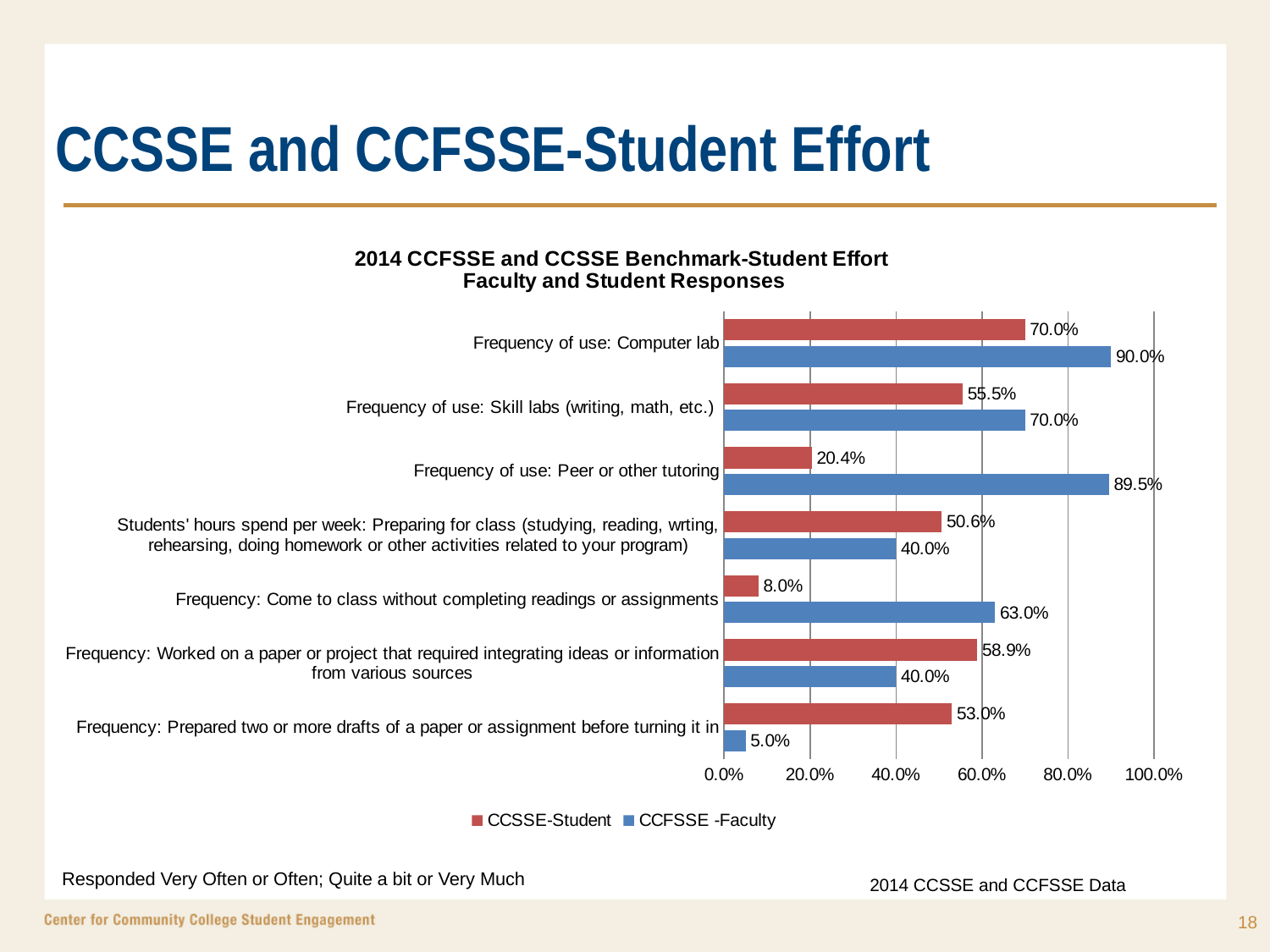
What kind of chart is shown on the slide? Bar chart What is the CCSSE-Student value for "Frequency of use: Peer or other tutoring"? 20.4% How many series does the legend list? 2 Which category has the highest CCFSSE-Faculty value? Frequency of use: Computer lab What is the difference between the CCFSSE-Faculty and CCSSE-Student values for "Frequency of use: Peer or other tutoring"? 69.1% What is the CCFSSE-Faculty value for "Frequency: Prepared two or more drafts of a paper or assignment before turning it in"? 5.0% Which category has the lowest CCSSE-Student value? Frequency: Come to class without completing readings or assignments For "Frequency: Worked on a paper or project that required integrating ideas or information from various sources", which series has the larger value, CCSSE-Student or CCFSSE-Faculty? CCSSE-Student Is the CCFSSE-Faculty value for "Frequency: Come to class without completing readings or assignments" greater or less than 60.0%? greater How many categories are plotted on the chart? 7 What is the CCFSSE-Faculty value for "Frequency of use: Computer lab"? 90.0% Which colour represents the CCFSSE-Faculty series in the chart? Blue